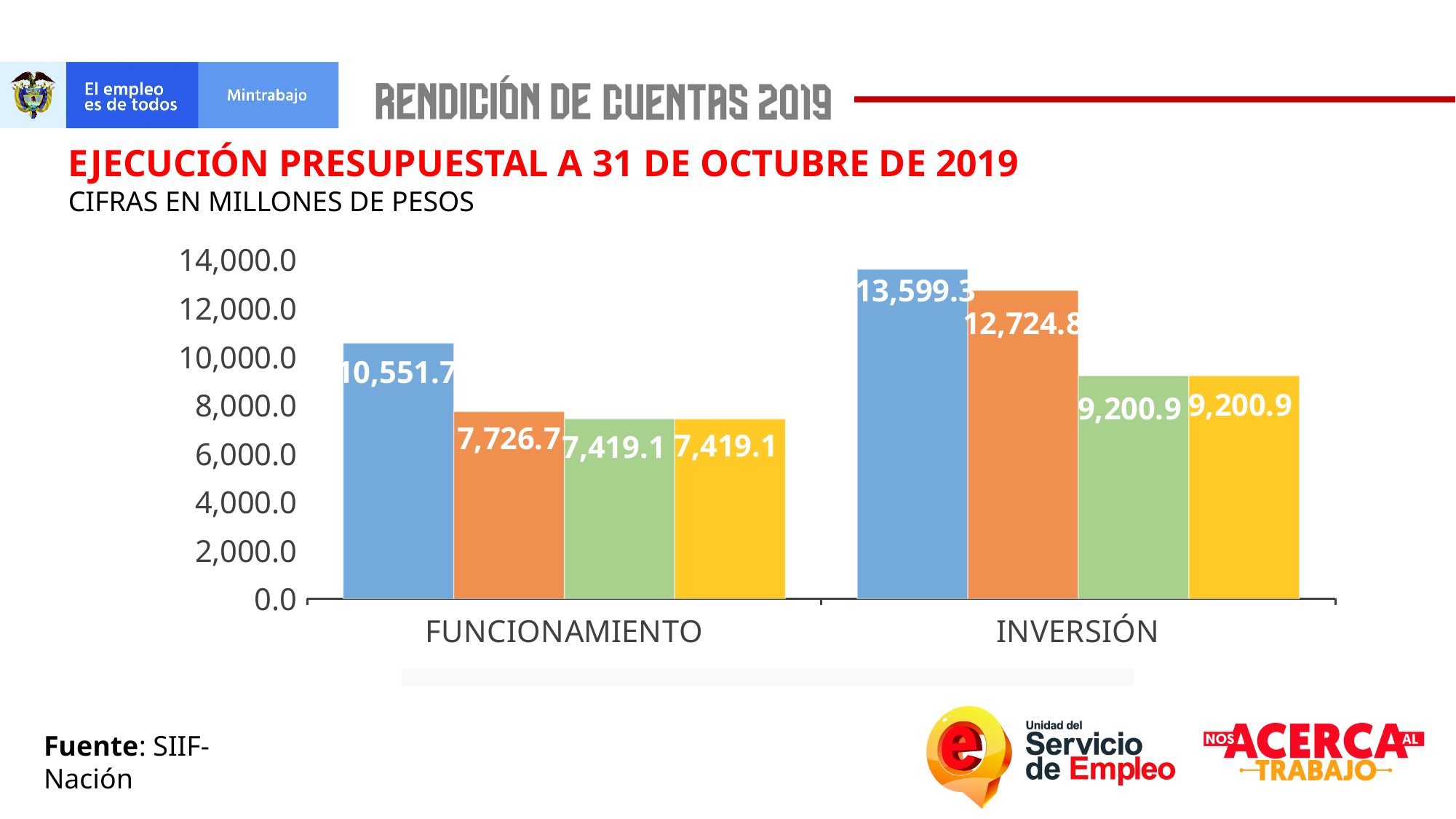
Which bar has the highest value in the whole chart? the blue bar for INVERSIÓN (13,599.3) What is the value of the blue bar for FUNCIONAMIENTO? 10,551.7 What unit are the figures in the chart expressed in, according to the subtitle? Millones de pesos What is the value of the orange bar for INVERSIÓN? 12,724.8 What is the value of the green bar for INVERSIÓN? 9,200.9 How many bars are plotted for the FUNCIONAMIENTO category? 4 How many categories are shown on the x axis of the chart? 2 Which is larger: the orange bar for FUNCIONAMIENTO or the green bar for INVERSIÓN? the green bar for INVERSIÓN What is the lowest value shown in the chart? 7,419.1 What is the difference between the blue bar for INVERSIÓN and the blue bar for FUNCIONAMIENTO? 3,047.6 What type of chart is shown on the slide? bar chart What is the value of the orange bar for FUNCIONAMIENTO? 7,726.7